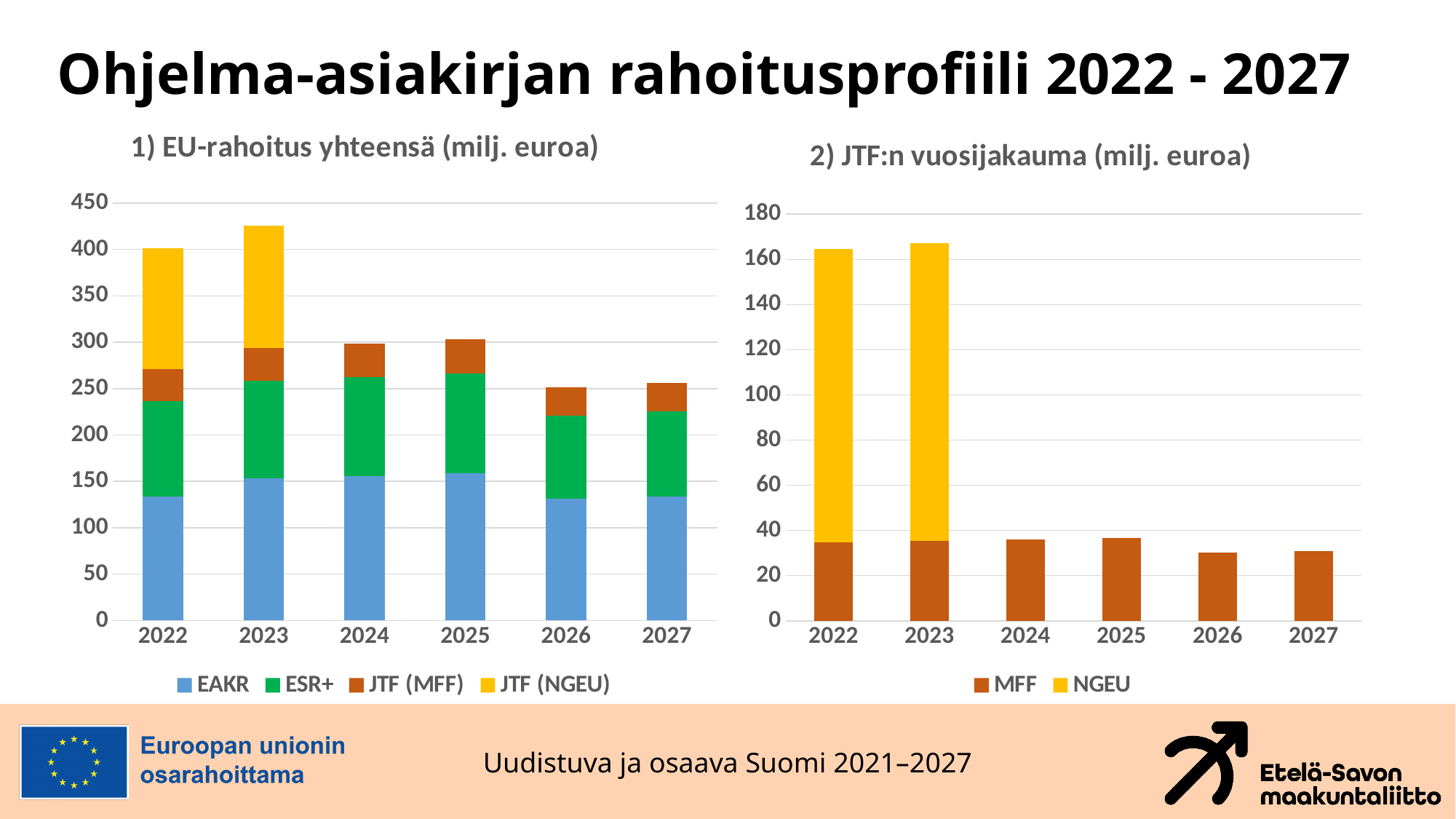
What kind of chart is the left chart, '1) EU-rahoitus yhteensä (milj. euroa)'? Stacked bar chart How many years are shown on the x axis of the right chart '2) JTF:n vuosijakauma'? 6 In the right chart '2) JTF:n vuosijakauma', is the total for 2022 greater or less than 140? greater How many series does the legend of the left chart '1) EU-rahoitus yhteensä' list? 4 In the left chart '1) EU-rahoitus yhteensä', which year has the highest total bar? 2023 In the right chart '2) JTF:n vuosijakauma', is the value for 2024 greater or less than 40? less In the left chart '1) EU-rahoitus yhteensä', which total is larger, 2024 or 2026? 2024 In the left chart '1) EU-rahoitus yhteensä', in which years does the JTF (NGEU) series appear? 2022 and 2023 In the left chart '1) EU-rahoitus yhteensä', is the total for 2026 greater or less than 300? less In the right chart '2) JTF:n vuosijakauma', which total is larger, 2022 or 2024? 2022 How many series does the legend of the right chart '2) JTF:n vuosijakauma' list? 2